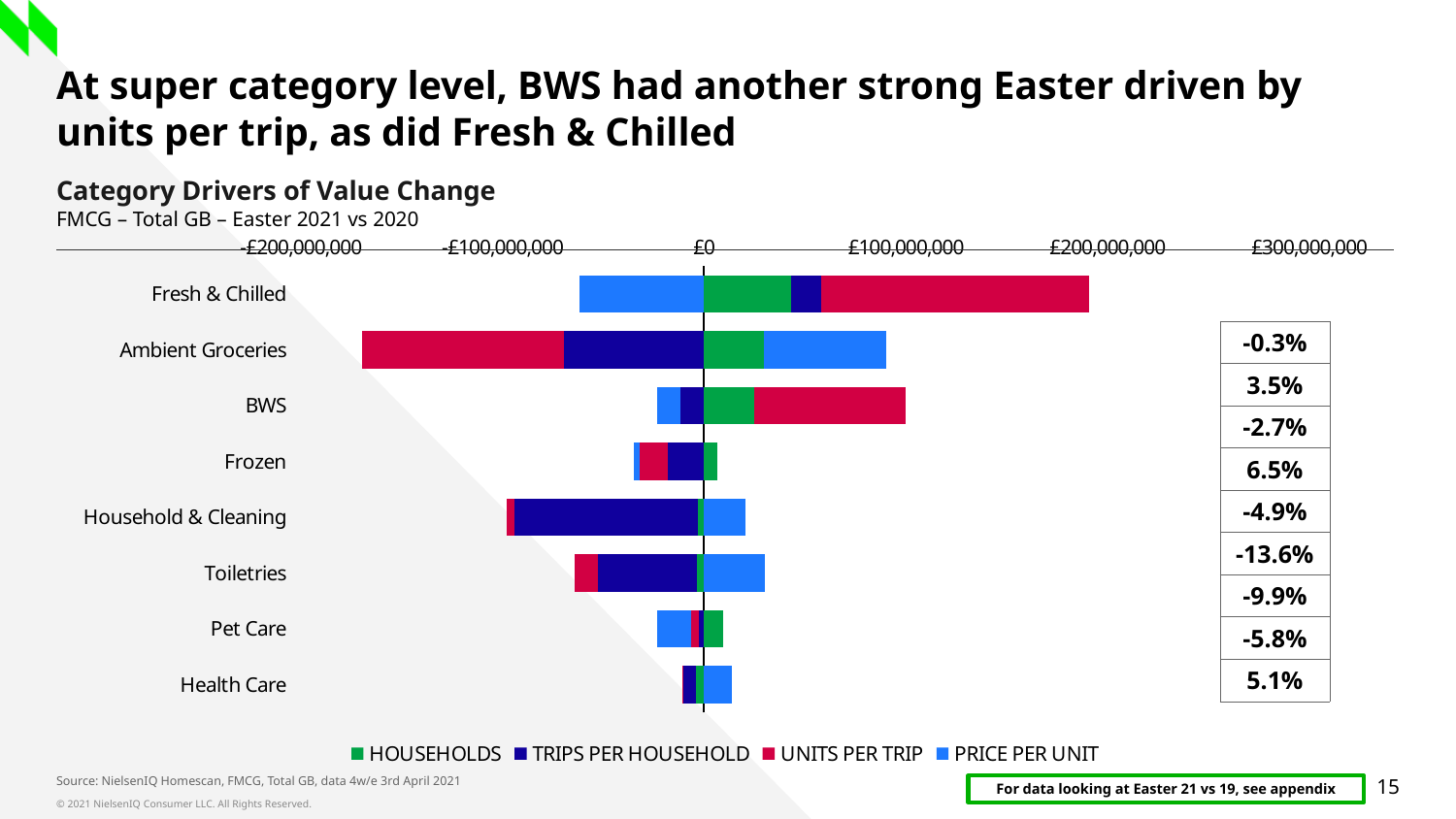
Which category has the largest positive UNITS PER TRIP segment? Fresh & Chilled Is the positive extent of the Fresh & Chilled bar greater or less than £100,000,000? greater Which category has the largest negative UNITS PER TRIP segment? Ambient Groceries Which category has the larger negative TRIPS PER HOUSEHOLD segment, Household & Cleaning or Toiletries? Household & Cleaning Which series is shown in red in the legend? UNITS PER TRIP How many series does the legend list? 4 Which category is listed first (at the top) on the chart? Fresh & Chilled Is the negative extent of the Ambient Groceries bar greater or less than -£100,000,000 (i.e. further from zero)? greater What kind of chart is shown on the slide? Bar chart What is the title of the chart? Category Drivers of Value Change How many categories are plotted on the chart? 8